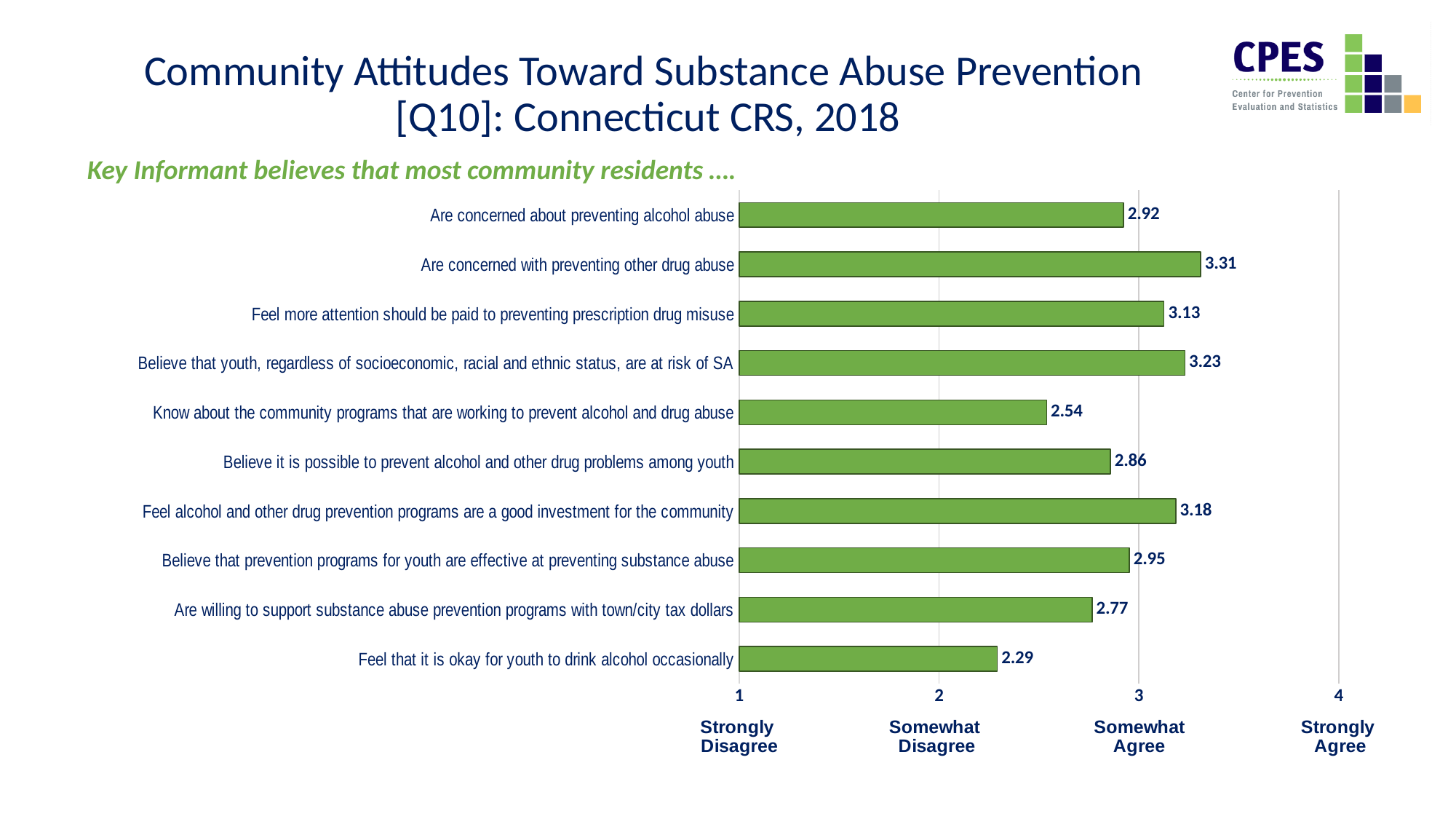
Which category has the highest value? Are concerned with preventing other drug abuse Which is larger: the value for "Feel alcohol and other drug prevention programs are a good investment for the community" or the value for "Believe that prevention programs for youth are effective at preventing substance abuse"? Feel alcohol and other drug prevention programs are a good investment for the community What kind of chart is shown on the slide? Bar chart Is the value for "Are willing to support substance abuse prevention programs with town/city tax dollars" greater or less than 3? less What is the value for "Are concerned with preventing other drug abuse"? 3.31 Which category has the lowest value? Feel that it is okay for youth to drink alcohol occasionally What is the value for "Feel that it is okay for youth to drink alcohol occasionally"? 2.29 How many categories are shown in the chart? 10 What is the difference between the values for "Are concerned with preventing other drug abuse" and "Are concerned about preventing alcohol abuse"? 0.39 What is the value for "Know about the community programs that are working to prevent alcohol and drug abuse"? 2.54 What is the value for "Believe that youth, regardless of socioeconomic, racial and ethnic status, are at risk of SA"? 3.23 What label is shown at the value 4 on the x axis? Strongly Agree